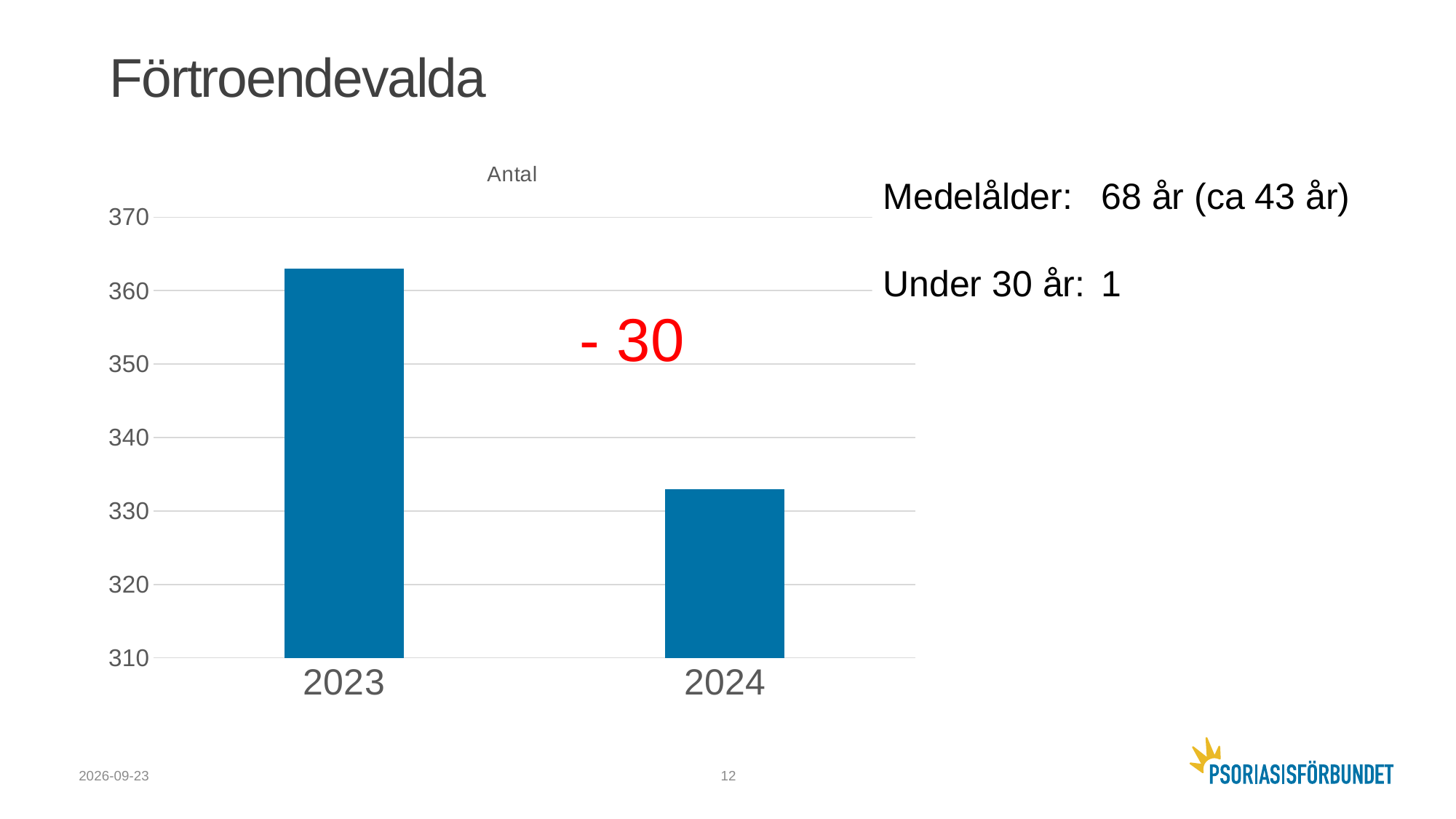
Which year has the highest value in the chart? 2023 Is the value for 2023 greater or less than 360? greater Do the values rise or fall from 2023 to 2024? fall What change between the two bars is annotated in red on the chart? - 30 What kind of chart is shown on the slide? bar chart Which year has the lowest value in the chart? 2024 How many bars (categories) does the chart show? 2 What is the title of the chart? Antal Is the value for 2024 greater or less than 340? less Is the value for 2024 greater or less than 320? greater Which is larger, the value for 2023 or the value for 2024? 2023